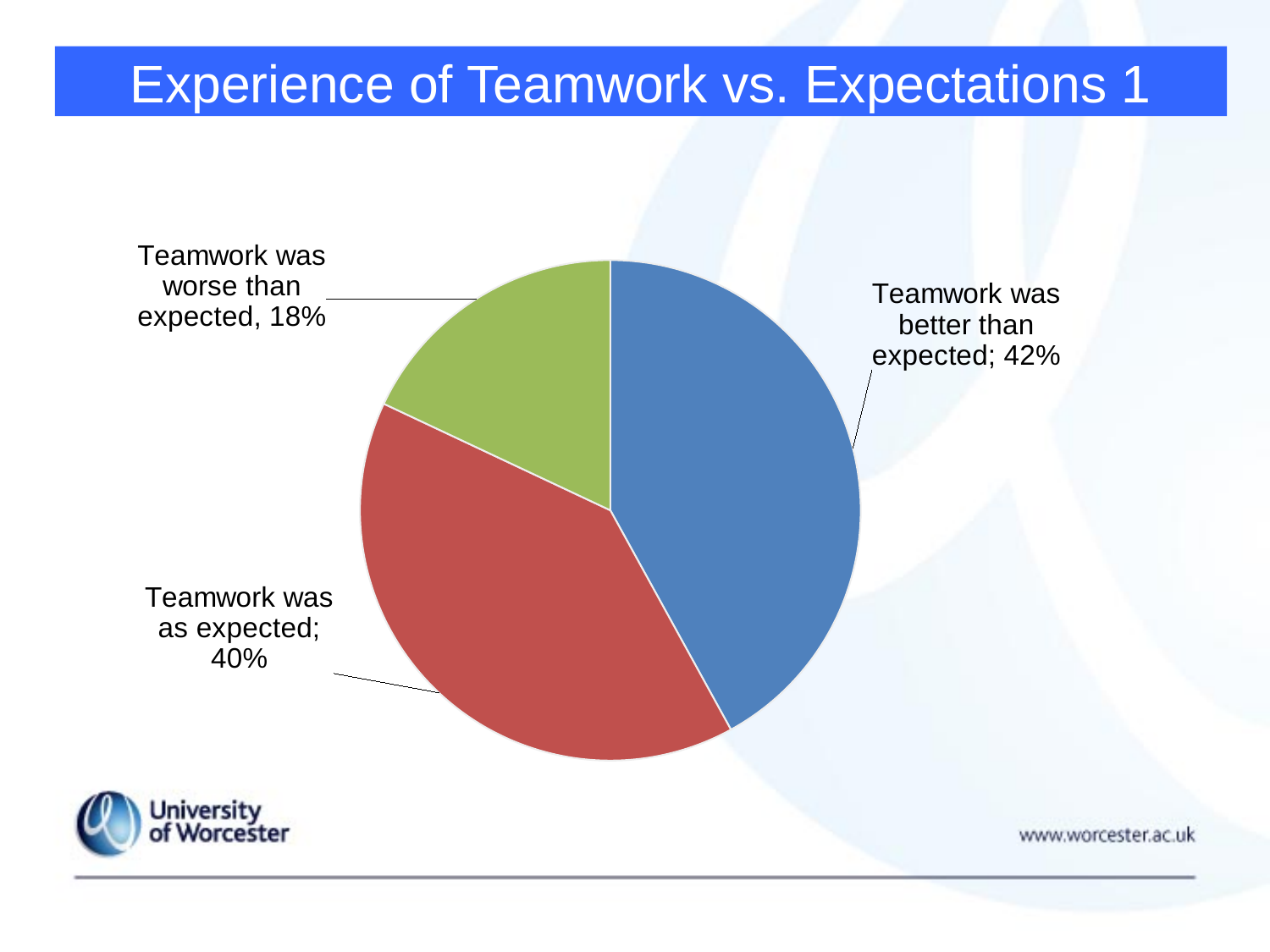
What percentage of respondents said teamwork was worse than expected? 18% What colour is the slice for 'Teamwork was as expected'? Red What percentage of respondents said teamwork was as expected? 40% Which category has the smallest share of the pie? Teamwork was worse than expected What percentage of respondents said teamwork was better than expected? 42% What is the difference in percentage points between 'Teamwork was as expected' and 'Teamwork was worse than expected'? 22 What is the title of the slide? Experience of Teamwork vs. Expectations 1 What kind of chart is shown on the slide? Pie chart Which category has the largest share of the pie? Teamwork was better than expected How many slices does the pie chart have? 3 What is the difference in percentage points between 'Teamwork was better than expected' and 'Teamwork was worse than expected'? 24 Which is larger: the share for 'Teamwork was as expected' or 'Teamwork was worse than expected'? Teamwork was as expected